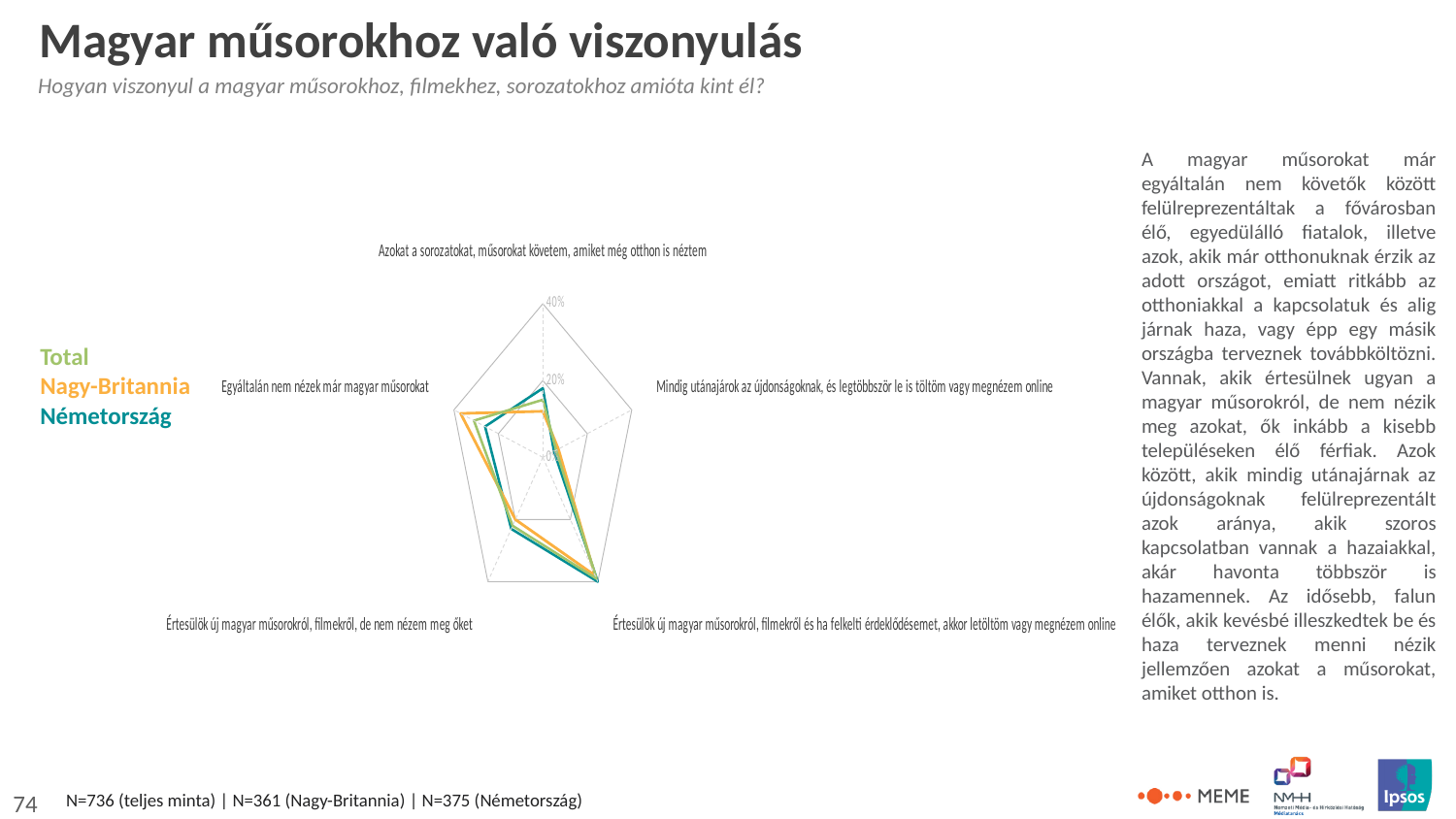
What is the highest percentage tick shown on the radar chart's axis? 40% Is the Total value for 'Mindig utánajárok az újdonságoknak, és legtöbbször le is töltöm vagy megnézem online' greater or less than 20%? less How many series does the legend of the radar chart list? 3 What kind of chart is shown on the slide? Radar chart Which is larger for the Total series: the value for 'Értesülök új magyar műsorokról, filmekről és ha felkelti érdeklődésemet, akkor letöltöm vagy megnézem online' or the value for 'Azokat a sorozatokat, műsorokat követem, amiket még otthon is néztem'? Értesülök új magyar műsorokról, filmekről és ha felkelti érdeklődésemet, akkor letöltöm vagy megnézem online Which category has the highest values on the radar chart? Értesülök új magyar műsorokról, filmekről és ha felkelti érdeklődésemet, akkor letöltöm vagy megnézem online Which series are listed in the legend of the radar chart? Total, Nagy-Britannia, Németország Is the Total value for 'Azokat a sorozatokat, műsorokat követem, amiket még otthon is néztem' greater or less than 20%? less How many categories (axes) does the radar chart have? 5 Is the Total value for 'Értesülök új magyar műsorokról, filmekről és ha felkelti érdeklődésemet, akkor letöltöm vagy megnézem online' greater or less than 20%? greater Which category has the lowest values on the radar chart? Mindig utánajárok az újdonságoknak, és legtöbbször le is töltöm vagy megnézem online